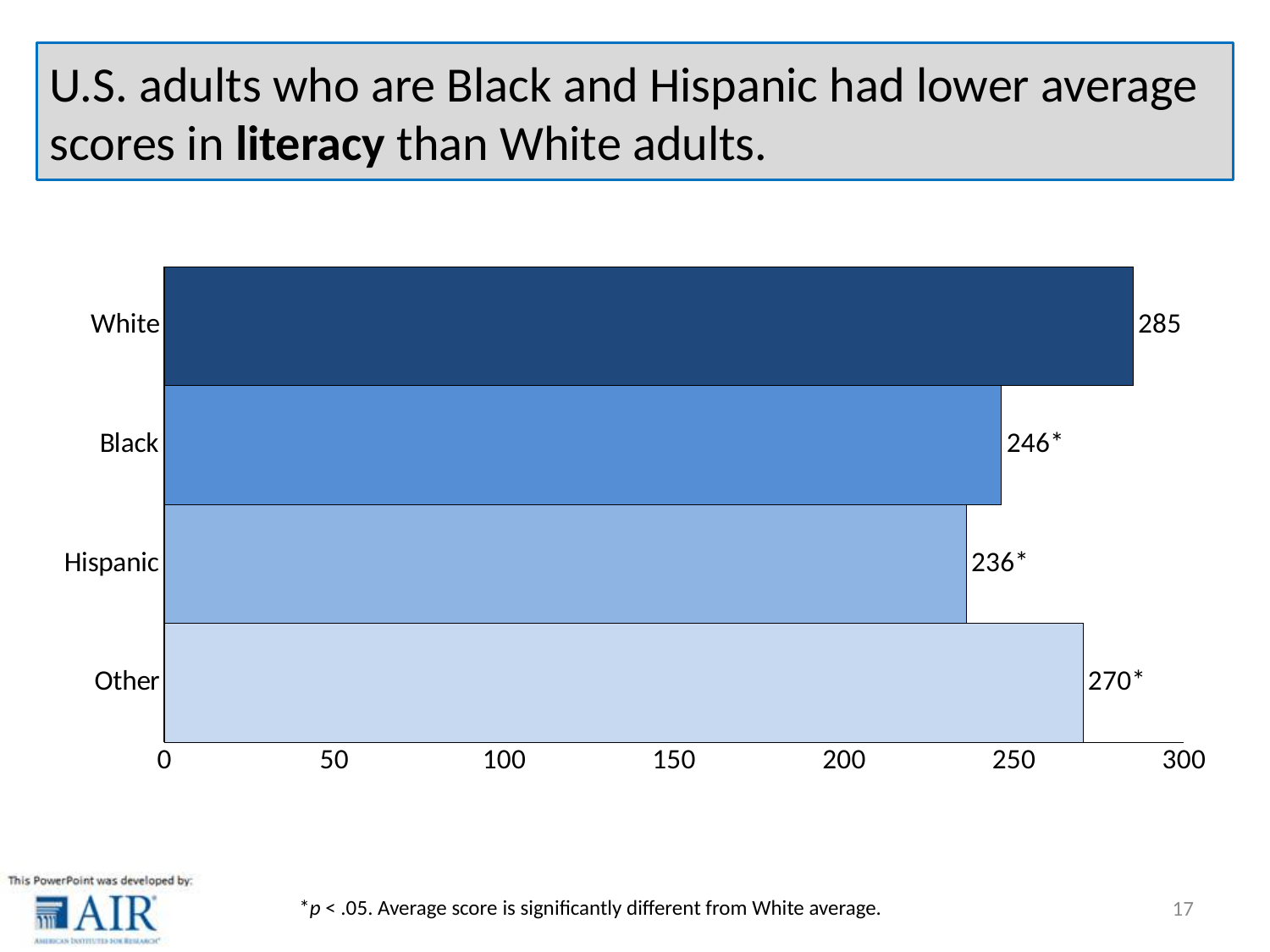
How many groups are shown in the chart? 4 Which group has a higher average literacy score, Black or Other? Other What is the difference between the average literacy scores of Other and Hispanic adults? 34 Which group has the lowest average literacy score? Hispanic What is the average literacy score for the Other group? 270* Which group has the highest average literacy score? White Is the value for Hispanic adults greater or less than 250? less What is the difference between the average literacy scores of White and Black adults? 39 What is the average literacy score for White adults? 285 What kind of chart is shown on the slide? Bar chart What is the average literacy score for Hispanic adults? 236* What is the average literacy score for Black adults? 246*